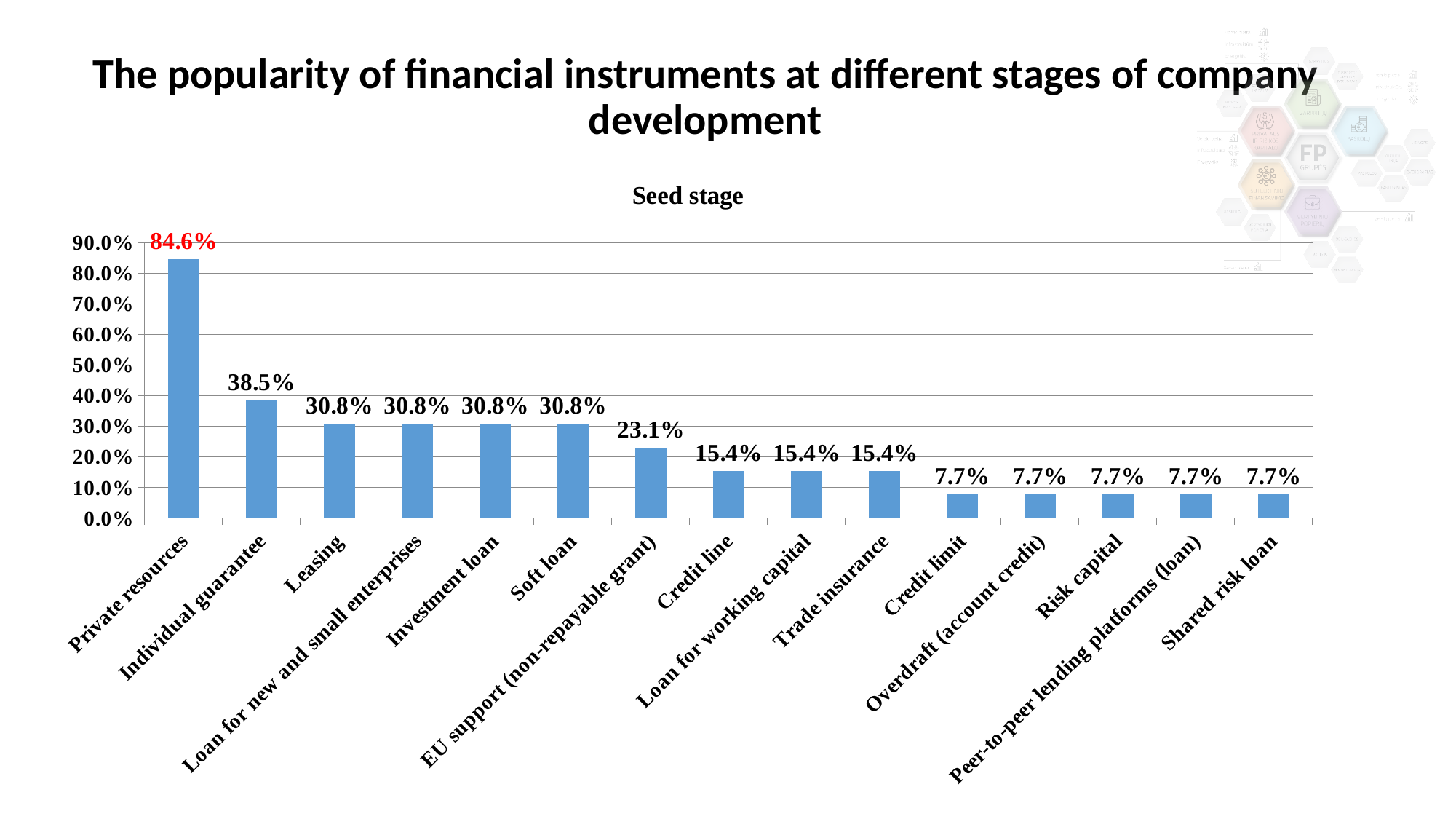
What is the value for Risk capital? 7.7% How many categories are shown on the x axis? 15 What is the value for EU support (non-repayable grant)? 23.1% What is the value for Trade insurance? 15.4% Which category has the highest value? Private resources What is the value for Individual guarantee? 38.5% What is the value for Private resources? 84.6% What is the title of the chart? Seed stage What is the difference between the values for Private resources and Individual guarantee? 46.1% What is the difference between the values for Leasing and Credit line? 15.4% Which is larger, the value for Soft loan or the value for Credit limit? Soft loan What kind of chart is shown on the slide? Bar chart